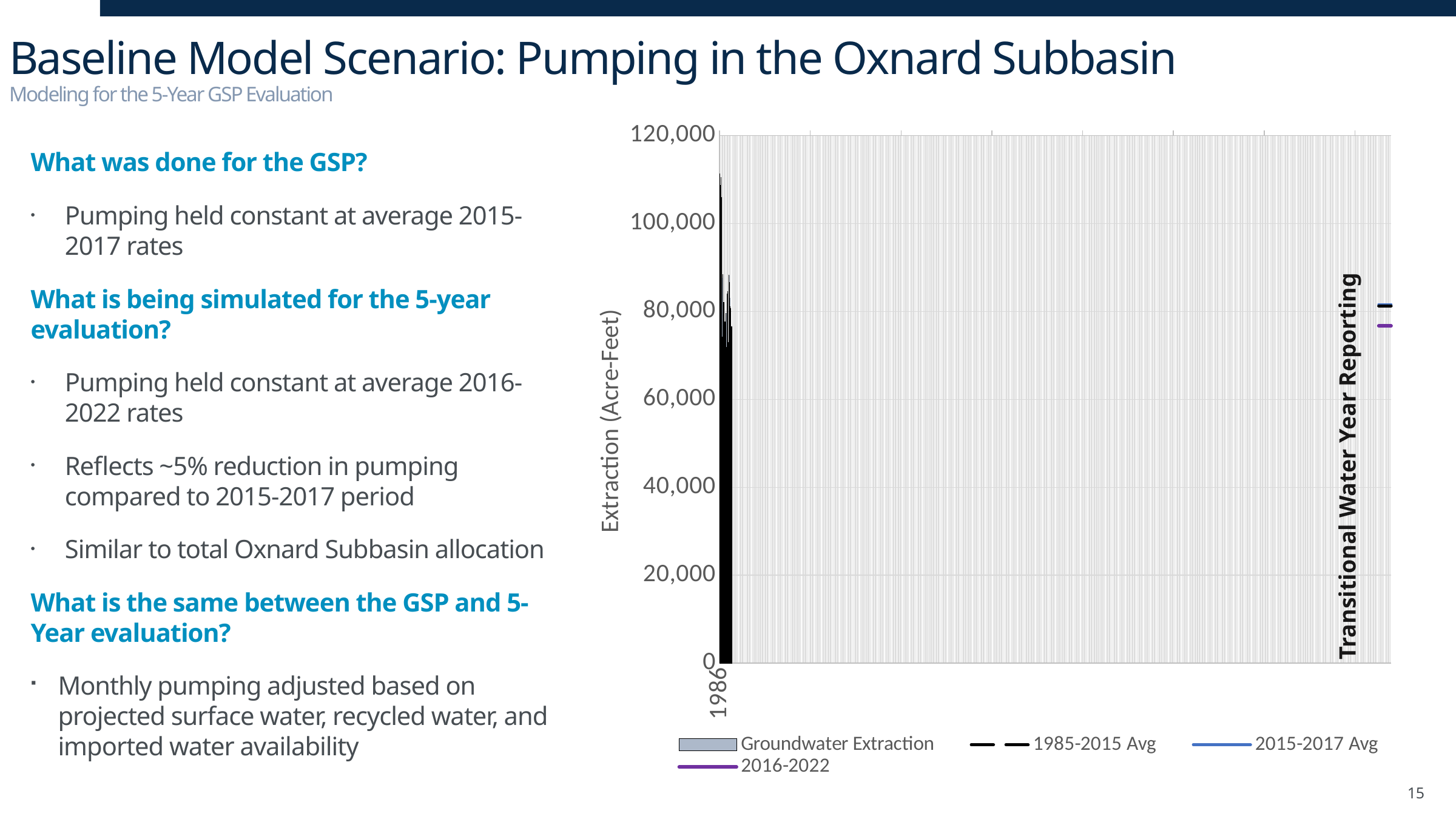
What is the label on the vertical axis of the chart? Extraction (Acre-Feet) Is the peak groundwater extraction value plotted on the chart greater or less than 100,000? greater What kind of chart is used to show Groundwater Extraction? bar chart What is the highest value shown on the chart's vertical axis? 120,000 How many series does the chart legend list? 4 Is the peak groundwater extraction value plotted on the chart greater or less than 120,000? less